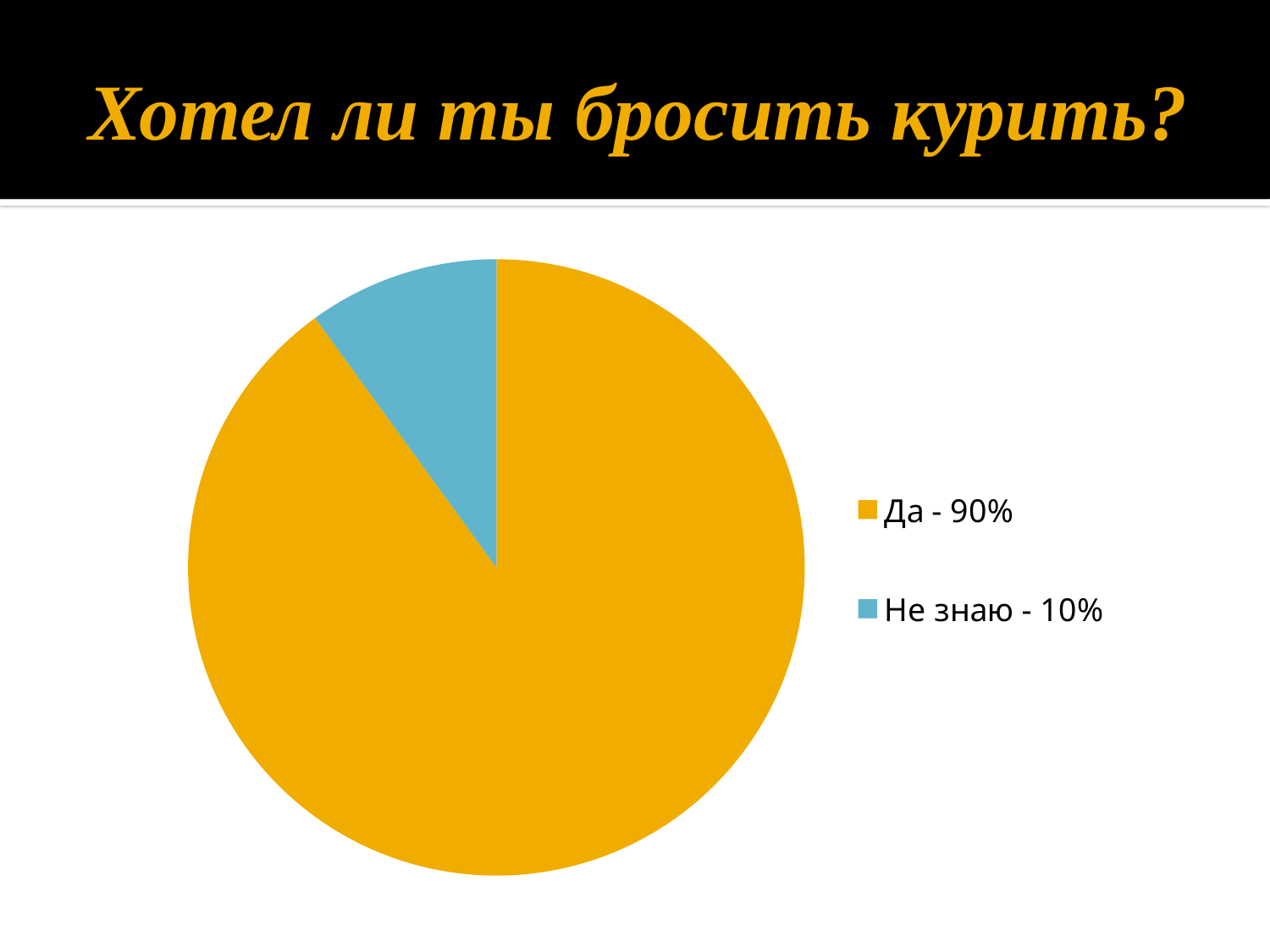
Which is larger, the slice for "Да" or the slice for "Не знаю"? Да Which category has the smallest slice of the pie? Не знаю How many entries does the legend list? 2 What colour is the slice for "Не знаю"? blue What share of the pie does "Да" represent? 90% What kind of chart is shown on the slide? pie chart How many categories does the pie chart have? 2 What share of the pie does "Не знаю" represent? 10% What is the title of the slide above the chart? Хотел ли ты бросить курить? Which category has the largest slice of the pie? Да What is the difference in percentage points between "Да" and "Не знаю"? 80